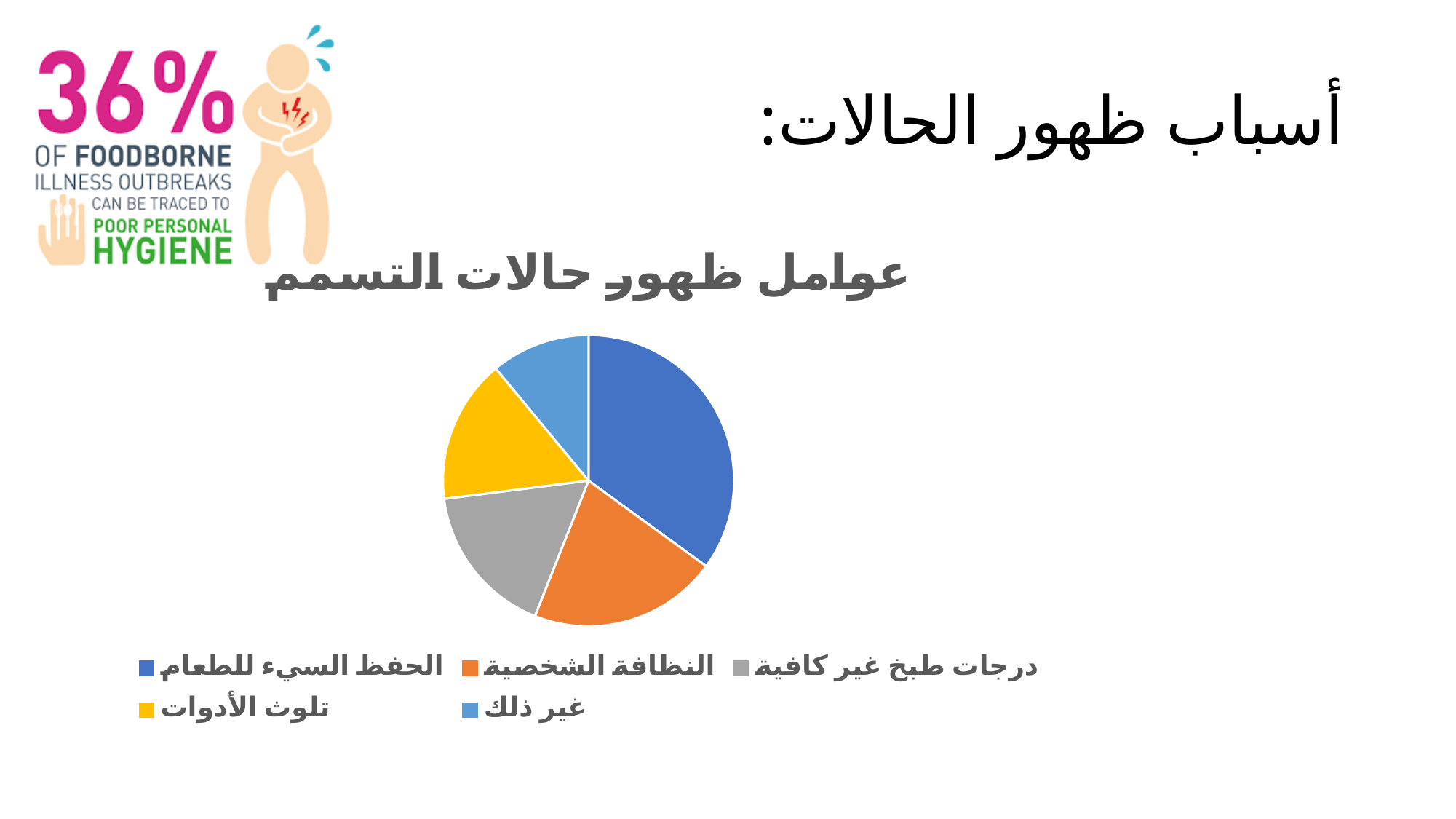
Which slice is larger: الحفظ السيء للطعام or النظافة الشخصية? الحفظ السيء للطعام Which category is shown in yellow in the pie chart? تلوث الأدوات Which slice is larger: النظافة الشخصية or غير ذلك? النظافة الشخصية What is the title of the chart? عوامل ظهور حالات التسمم What kind of chart is shown on the slide? pie chart Which category has the smallest slice of the pie? غير ذلك How many slices does the pie chart have? 5 Which category has the largest slice of the pie? الحفظ السيء للطعام How many entries does the chart legend list? 5 Which slice is larger: تلوث الأدوات or غير ذلك? تلوث الأدوات